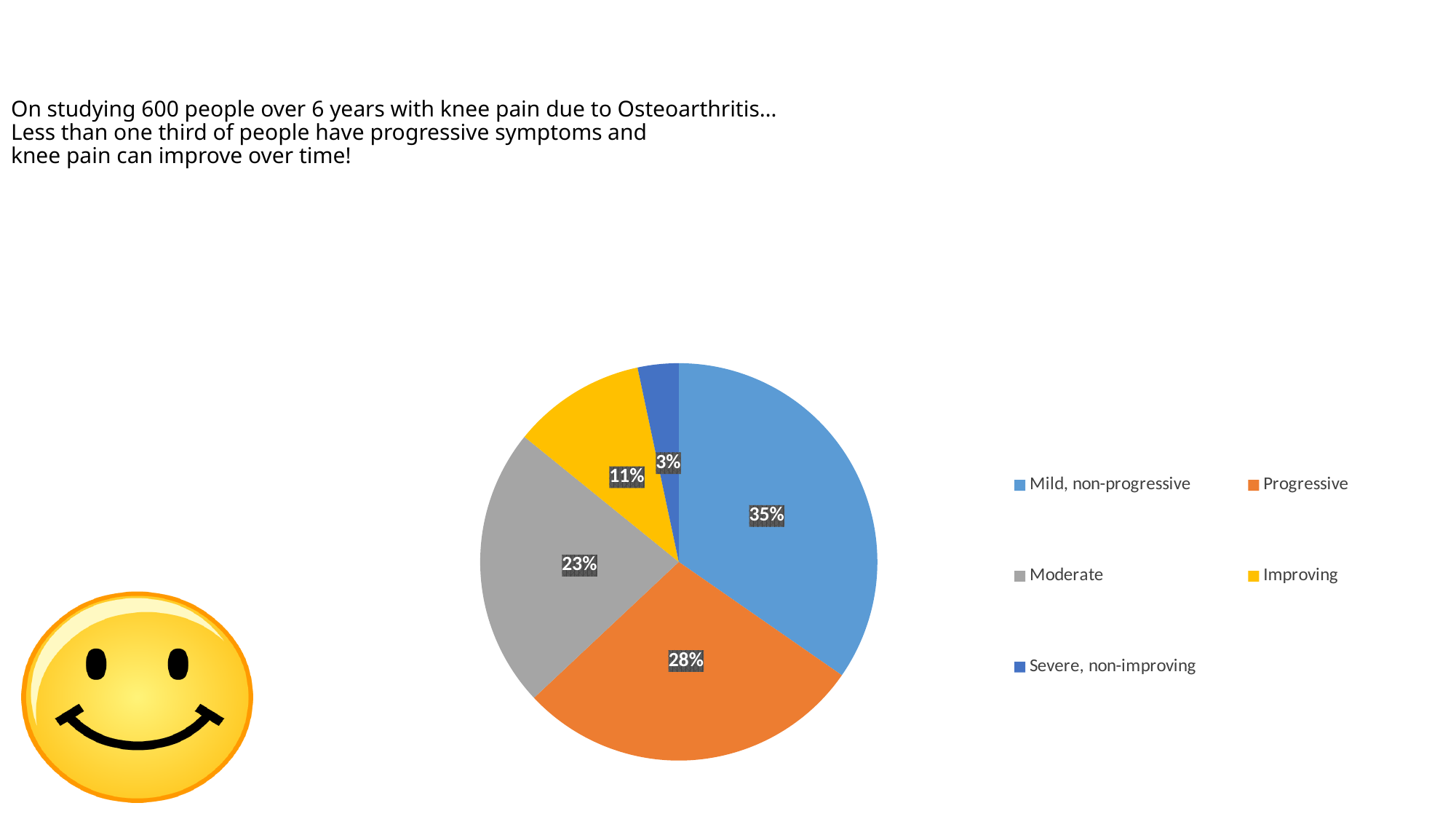
What percentage of the pie is the Mild, non-progressive slice? 35% What percentage of the pie is the Improving slice? 11% Which category has the smallest share of the pie? Severe, non-improving How many percentage points larger is the Progressive slice than the Improving slice? 17 What percentage of the pie is the Severe, non-improving slice? 3% Which slice is larger, Moderate or Progressive? Progressive Which category has the largest share of the pie? Mild, non-progressive What percentage of the pie is the Progressive slice? 28% What colour is the Improving slice? yellow What kind of chart is shown on the slide? pie chart How many categories does the pie chart have? 5 What percentage of the pie is the Moderate slice? 23%